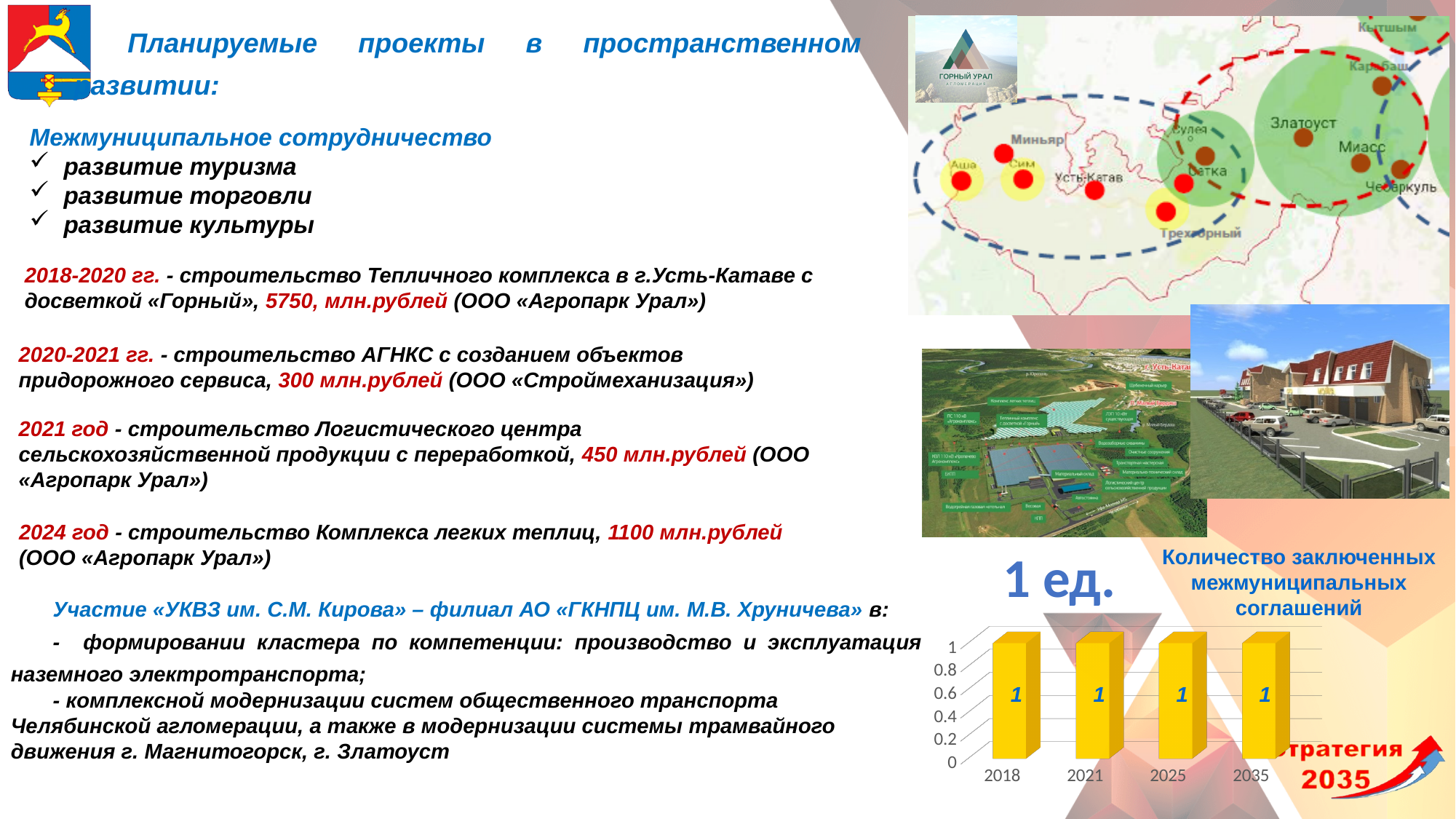
What is the value for 2025 in the chart? 1 Is the value for 2025 in the chart greater or less than 0.6? greater How many categories are shown on the x axis of the chart? 4 What is the highest tick value shown on the y axis of the chart? 1 What type of chart is shown on the slide? bar chart Do the values in the chart rise, fall, or stay the same from 2018 to 2035? stay the same What is the title of the chart on the slide? Количество заключенных межмуниципальных соглашений What is the value for 2018 in the chart? 1 What is the value for 2021 in the chart? 1 What is the value for 2035 in the chart? 1 What is the difference between the values for 2035 and 2018 in the chart? 0 What is the first year shown on the x axis of the chart? 2018